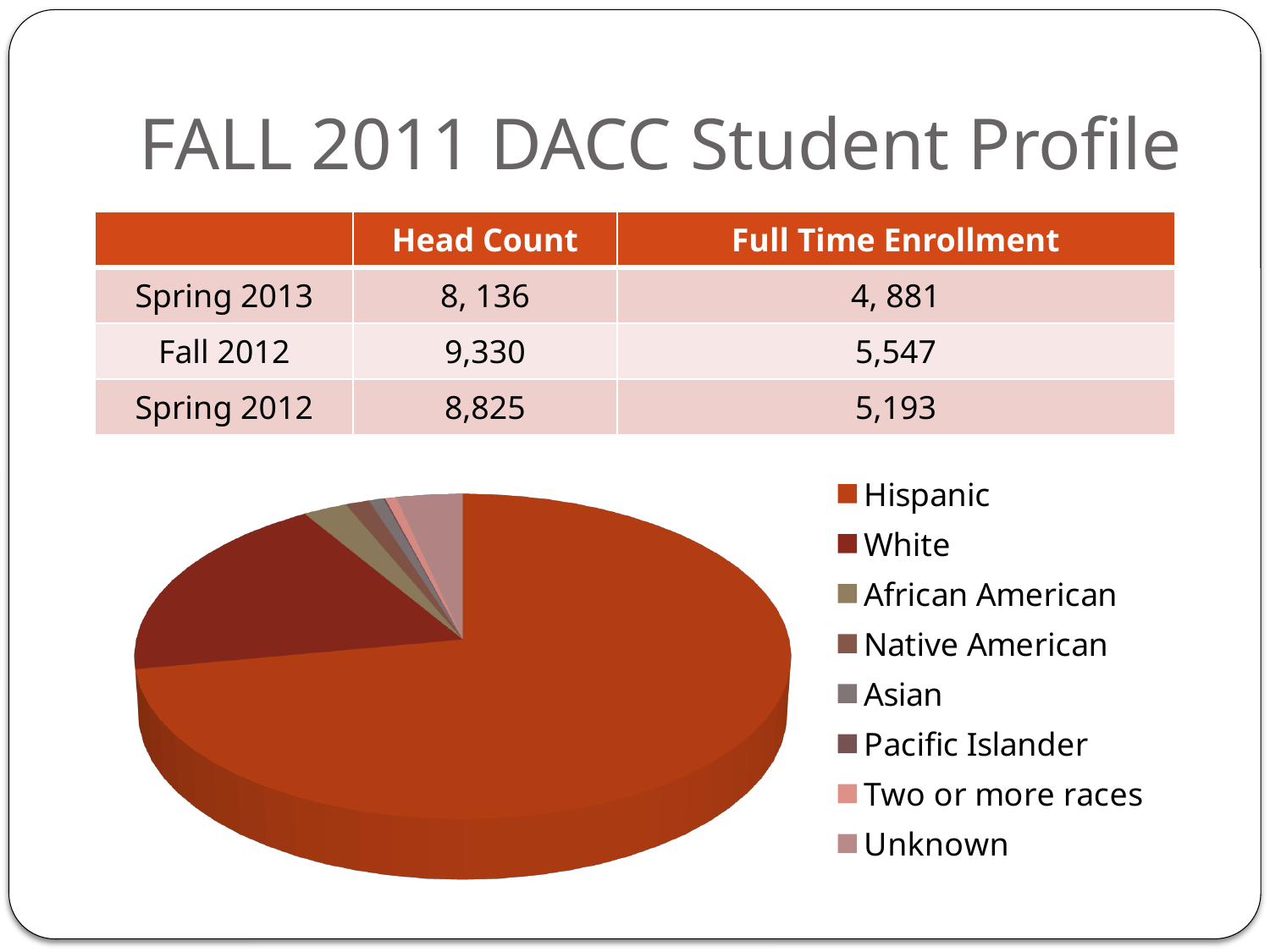
Which is larger in the pie chart, the Hispanic slice or the White slice? Hispanic How many categories does the pie chart's legend list? 8 Which category has the largest slice of the pie chart? Hispanic What kind of chart is shown on the slide? Pie chart What is the first category listed in the pie chart's legend? Hispanic Which category has the second-largest slice of the pie chart? White Which is larger in the pie chart, the White slice or the African American slice? White Which is larger in the pie chart, the Hispanic slice or the Unknown slice? Hispanic